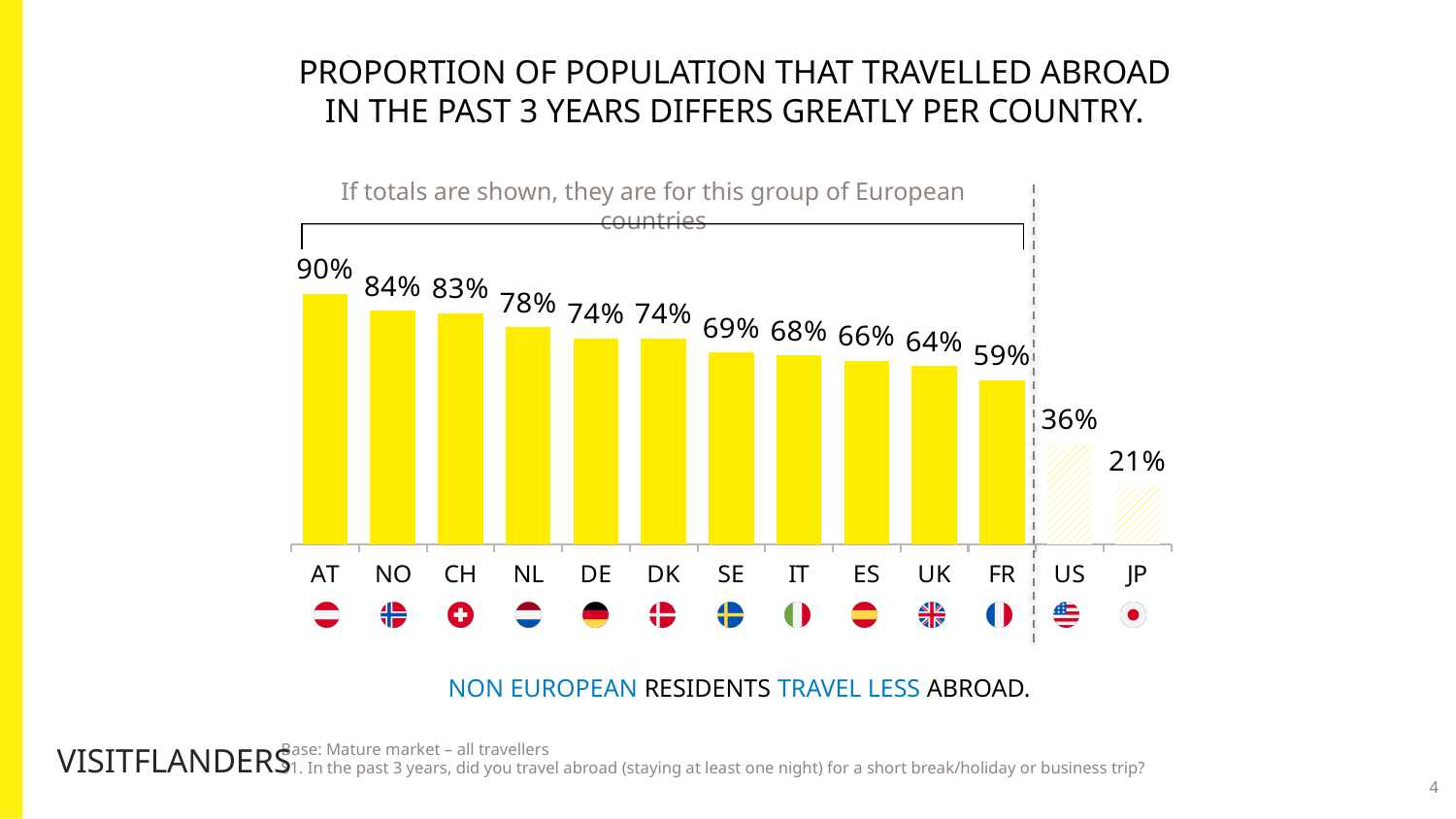
What is the value for US? 36% What is the value for FR? 59% How many countries are shown on the chart? 13 Do the values rise or fall from left to right along the x axis? fall Which is larger, the value for SE or the value for ES? SE Which country has the highest value? AT What kind of chart is this? bar chart Which two countries both have a value of 74%? DE and DK Which country has the lowest value? JP What is the difference between the values for AT and JP? 69% What is the difference between the values for NL and UK? 14% What is the value for AT? 90%